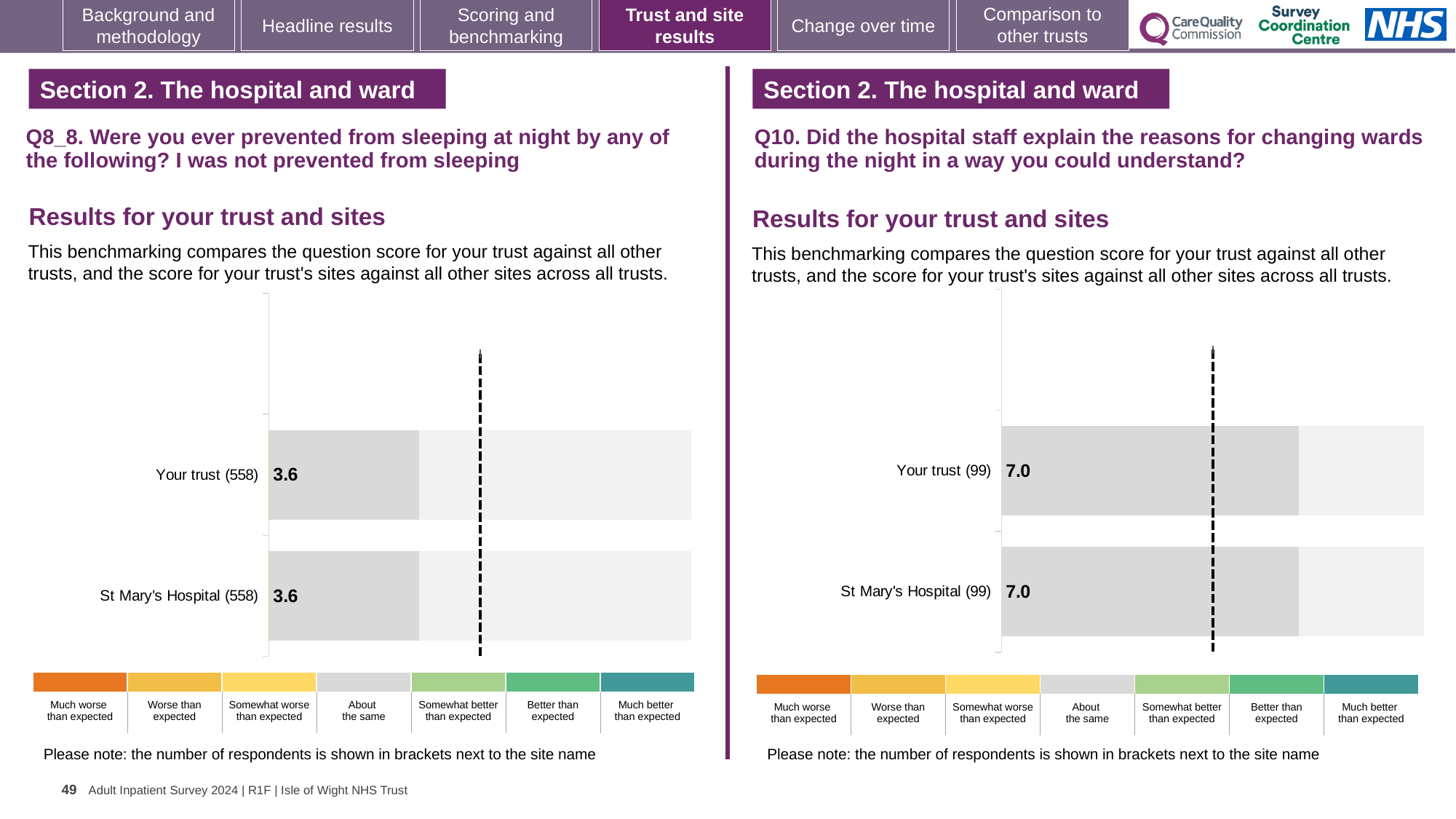
What kind of chart is used on the left (Q8_8)? Bar chart In the right chart (Q10), how many respondents are shown in brackets next to St Mary's Hospital? 99 How many bars are plotted in the left chart (Q8_8)? 2 In the left chart (Q8_8), what is the score for St Mary's Hospital? 3.6 In the left chart (Q8_8), what is the score for Your trust? 3.6 In the right chart (Q10), what is the score for St Mary's Hospital? 7.0 In the left chart (Q8_8), what is the difference between the score for Your trust and the score for St Mary's Hospital? 0.0 In the left chart (Q8_8), how many respondents are shown in brackets next to Your trust? 558 In the right chart (Q10), what is the difference between the score for Your trust and the score for St Mary's Hospital? 0.0 In the right chart (Q10), what is the score for Your trust? 7.0 Is the score for Your trust in the right chart (Q10) greater or less than the score for Your trust in the left chart (Q8_8)? greater How many bars are plotted in the right chart (Q10)? 2